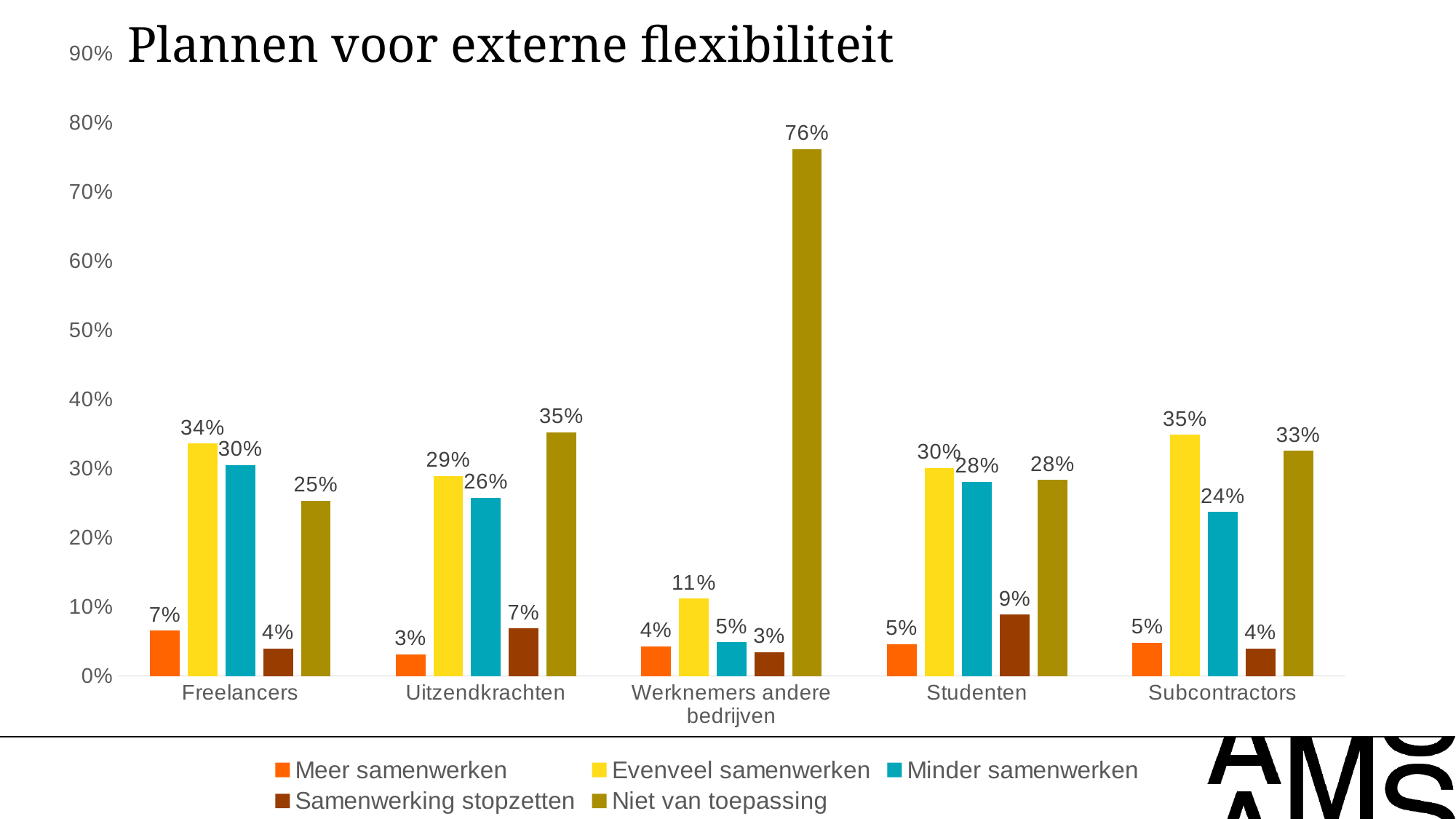
Which is larger for Subcontractors: "Evenveel samenwerken" or "Niet van toepassing"? Evenveel samenwerken What kind of chart is shown on the slide? Bar chart How many series does the legend list? 5 Which category has the lowest value for "Meer samenwerken"? Uitzendkrachten What is the value of "Samenwerking stopzetten" for Studenten? 9% What is the value of "Minder samenwerken" for Subcontractors? 24% What is the title of the chart? Plannen voor externe flexibiliteit What is the value of "Niet van toepassing" for Werknemers andere bedrijven? 76% What is the value of "Evenveel samenwerken" for Freelancers? 34% What is the difference between "Evenveel samenwerken" and "Minder samenwerken" for Uitzendkrachten? 3% How many categories are shown on the x axis? 5 Which category has the highest value for "Niet van toepassing"? Werknemers andere bedrijven